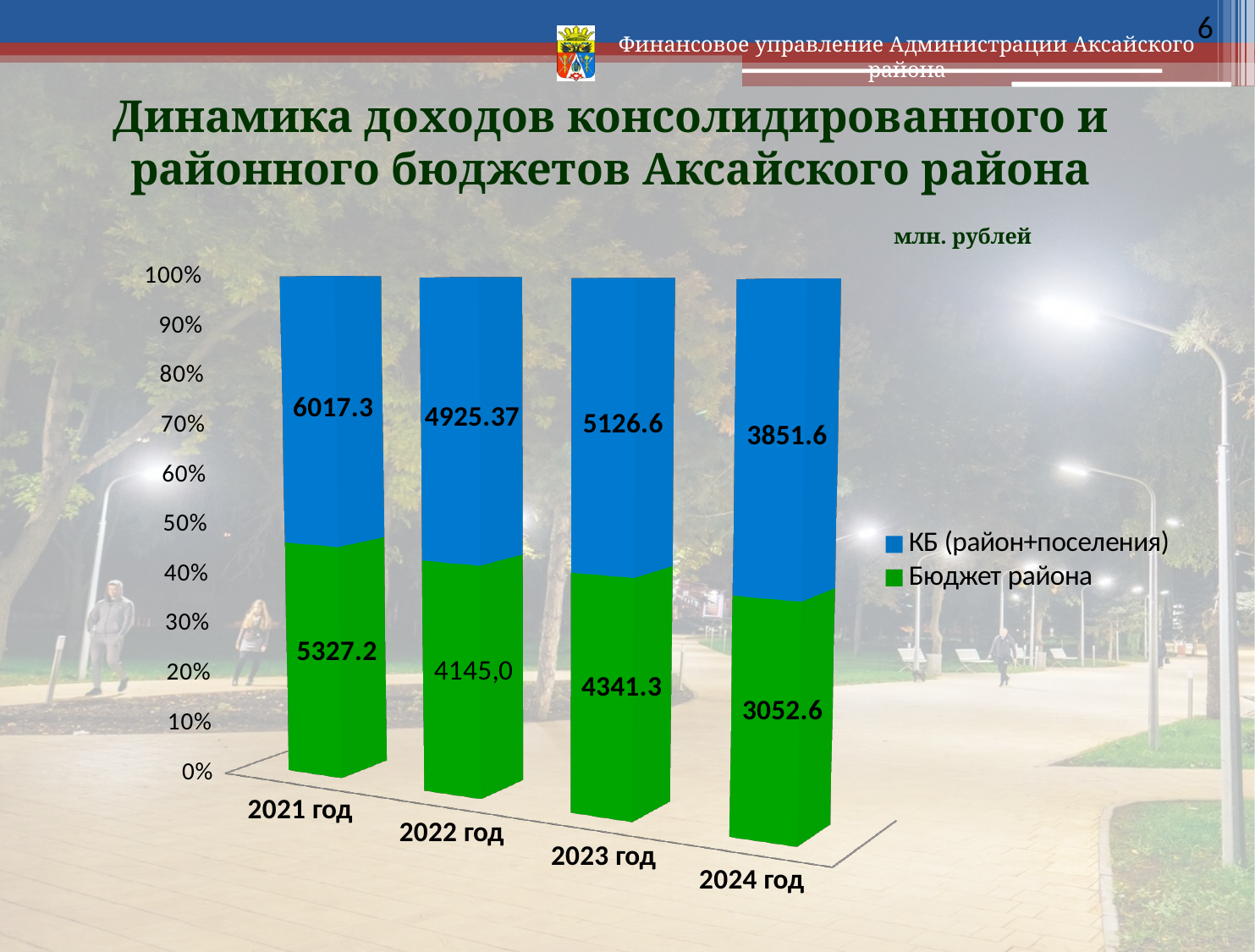
What is the difference between the КБ (район+поселения) value and the Бюджет района value in 2024 год? 799.0 In which year is the value for Бюджет района the lowest? 2024 год How many series does the legend list? 2 How many years are shown on the x axis? 4 In which year is the value for КБ (район+поселения) the highest? 2021 год Which is larger: the КБ (район+поселения) value in 2022 год or in 2023 год? 2023 год What is the value for Бюджет района in 2024 год? 3052.6 What unit is stated above the chart? млн. рублей What is the value for Бюджет района in 2022 год? 4145,0 What is the value for КБ (район+поселения) in 2021 год? 6017.3 What kind of chart is shown on the slide? Stacked bar chart What is the value for КБ (район+поселения) in 2023 год? 5126.6